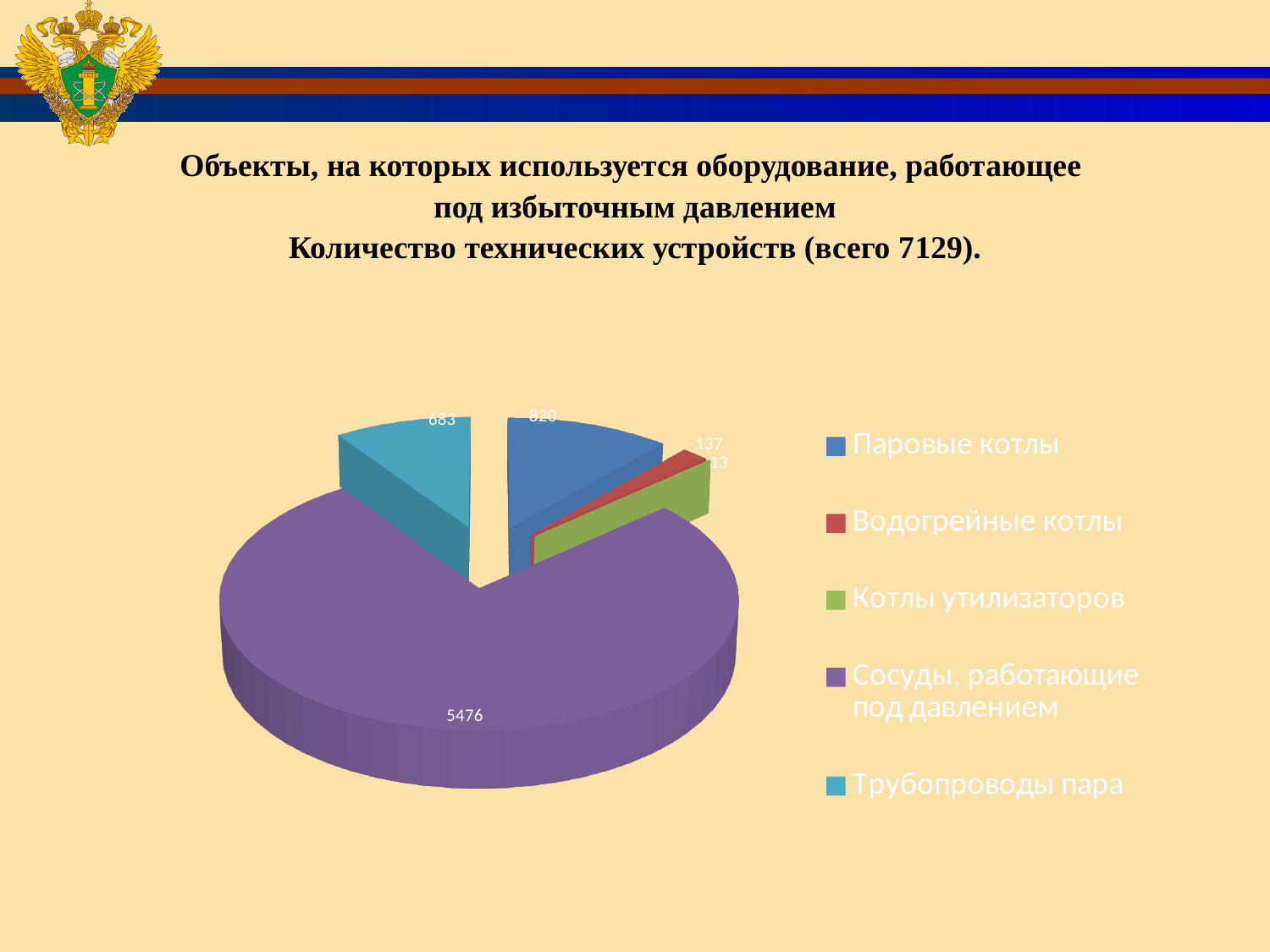
What kind of chart is shown on the slide? pie chart Which is larger, the value for Водогрейные котлы or the value for Трубопроводы пара? Трубопроводы пара What is the value for Паровые котлы? 820 How many categories does the legend of the pie chart list? 5 What is the value for Трубопроводы пара? 683 What is the value for Котлы утилизаторов? 13 Which category has the smallest slice of the pie? Котлы утилизаторов What is the value for Сосуды, работающие под давлением? 5476 Which category has the largest slice of the pie? Сосуды, работающие под давлением What total number of technical devices is stated in the chart title? 7129 What is the difference between the values for Паровые котлы and Трубопроводы пара? 137 What is the value for Водогрейные котлы? 137